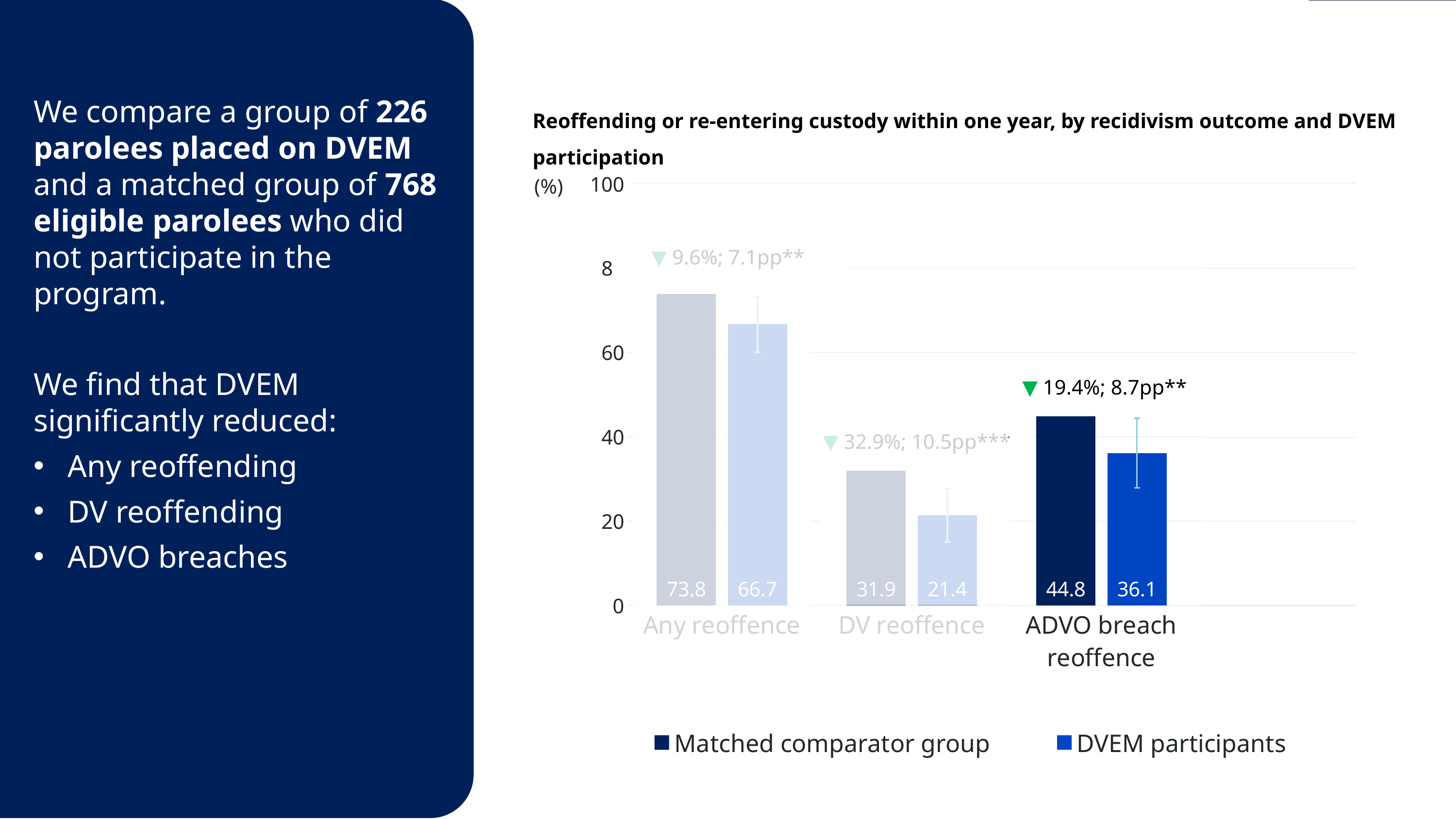
What is the value for DVEM participants for DV reoffence? 21.4 Which category has the lowest value for DVEM participants? DV reoffence What is the value for the Matched comparator group for ADVO breach reoffence? 44.8 What kind of chart is shown on the slide? Bar chart What is the difference between the Matched comparator group and DVEM participants for DV reoffence? 10.5 What is the difference between the Matched comparator group and DVEM participants for ADVO breach reoffence? 8.7 What is the value for the Matched comparator group for Any reoffence? 73.8 Which is larger for Any reoffence: the Matched comparator group or DVEM participants? Matched comparator group How many series does the legend list? 2 How many categories are shown on the x axis? 3 Which category has the highest value for the Matched comparator group? Any reoffence What is the value for DVEM participants for ADVO breach reoffence? 36.1